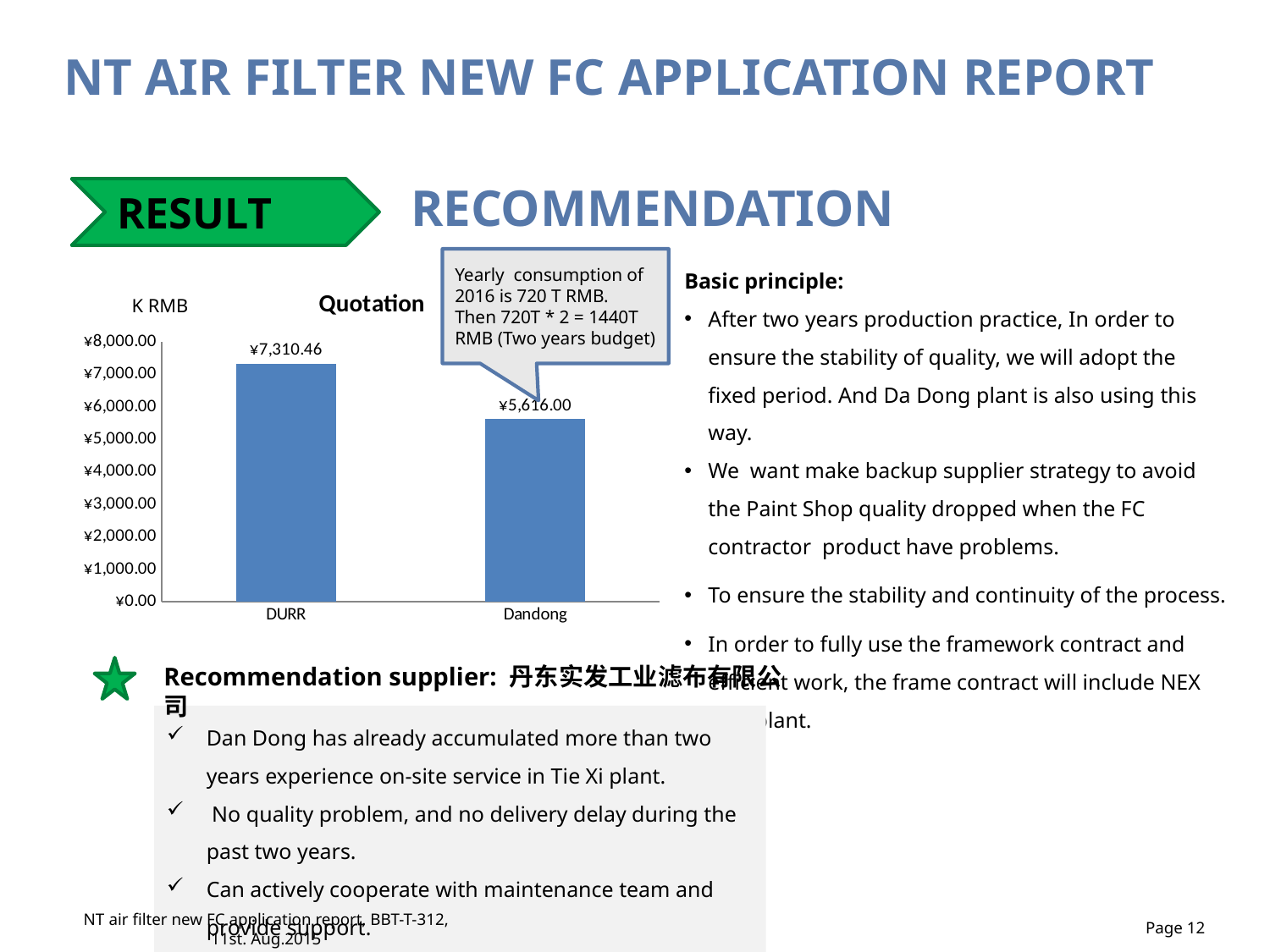
Is the quotation for DURR greater or less than ¥7,000.00? greater What is the quotation value for Dandong? ¥5,616.00 What is the difference between the DURR and Dandong quotations? ¥1,694.46 Which is larger, the quotation for DURR or for Dandong? DURR What type of chart is used to show the quotations? Bar chart What unit is shown on the chart's vertical axis label? K RMB What is the quotation value for DURR? ¥7,310.46 Which supplier has the lowest quotation in the chart? Dandong Is the quotation for Dandong greater or less than ¥6,000.00? less Which supplier has the highest quotation in the chart? DURR What is the title of the chart? Quotation How many suppliers are shown in the Quotation chart? 2